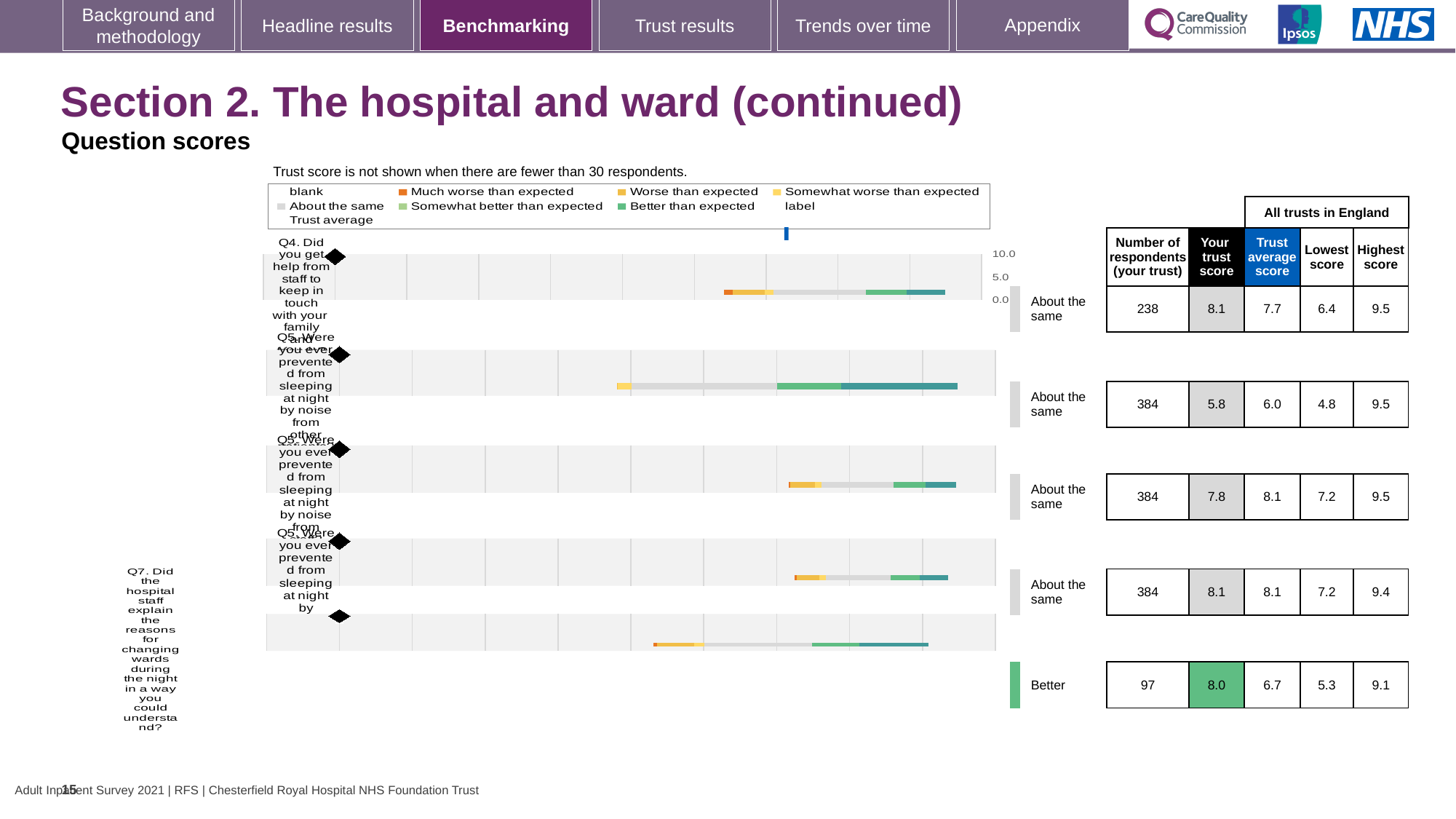
What is your trust score for Q4 about getting help from staff to keep in touch with family and friends? 8.1 What is the trust average score for Q7 about explaining the reasons for changing wards during the night? 6.7 For Q4, which is larger: your trust score or the trust average score? your trust score Which question has the lowest number of respondents? Q7 Which colour does the legend use for 'Much worse than expected'? orange How many respondents (your trust) are shown for Q7 about explaining the reasons for changing wards during the night? 97 For Q7, what is the difference between the highest score and the lowest score across all trusts in England? 3.8 What is the lowest score across all trusts in England for Q4? 6.4 What is the highest tick value shown on the chart's score axis? 10.0 What kind of chart is used to show the question scores on this slide? bar chart Which benchmark category is shown for Q7 about explaining the reasons for changing wards during the night? Better How many question rows (bars) are plotted in the chart? 5